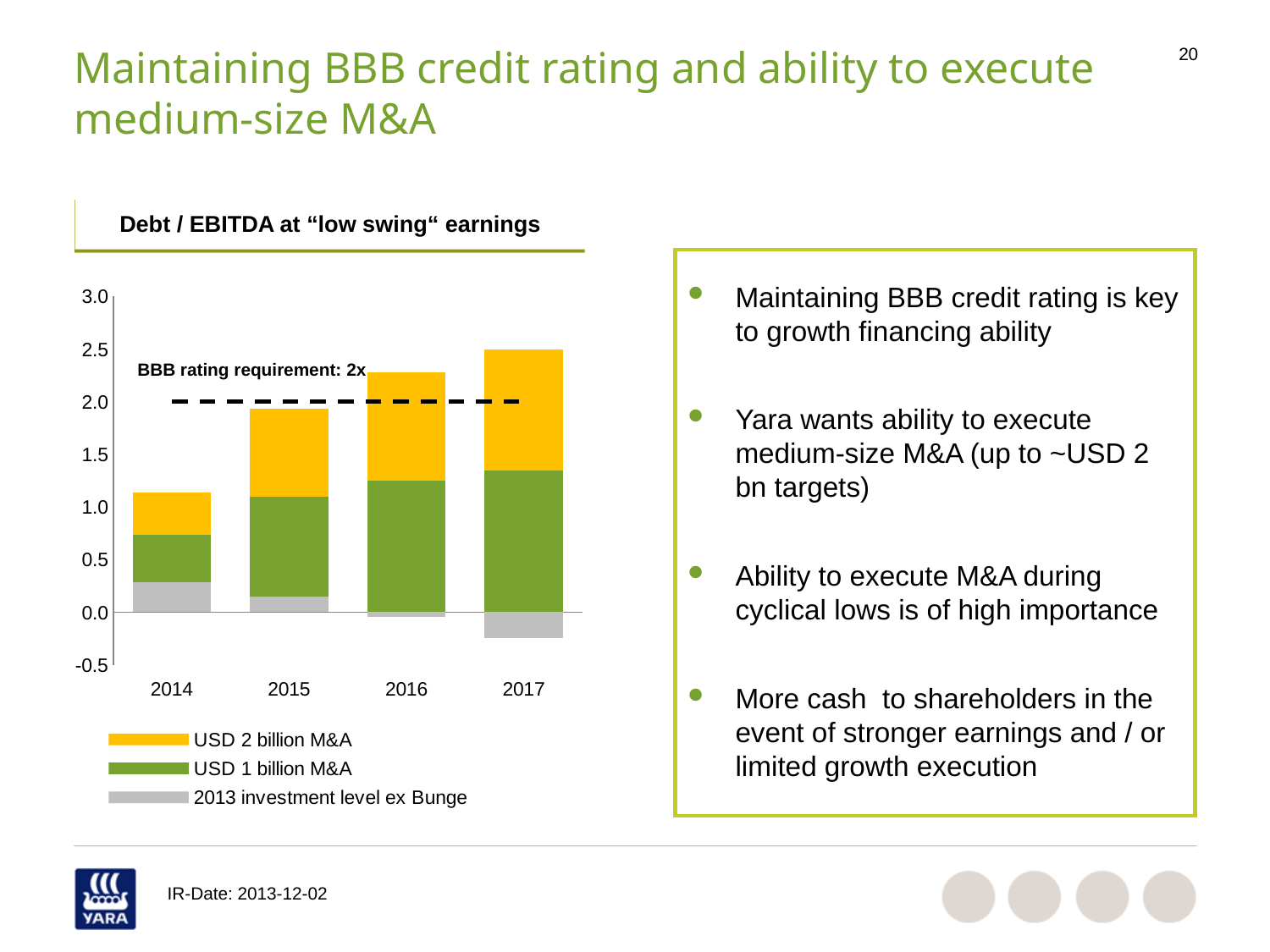
What is the title of the chart? Debt / EBITDA at "low swing" earnings Is the total stacked bar for 2017 greater or less than 2.0? greater Is the total stacked bar for 2014 greater or less than 1.5? less Is the total stacked bar for 2016 greater or less than 2.0? greater Which year has the lowest total stacked bar in the chart? 2014 Which year has the larger total stacked bar, 2014 or 2016? 2016 What kind of chart is shown on the slide? bar chart Do the total stacked bars rise or fall from 2014 to 2017? rise Which year has the highest total stacked bar in the chart? 2017 What value does the dashed line in the chart mark, according to its label? BBB rating requirement: 2x How many years are shown on the x axis of the chart? 4 How many series does the chart legend list? 3